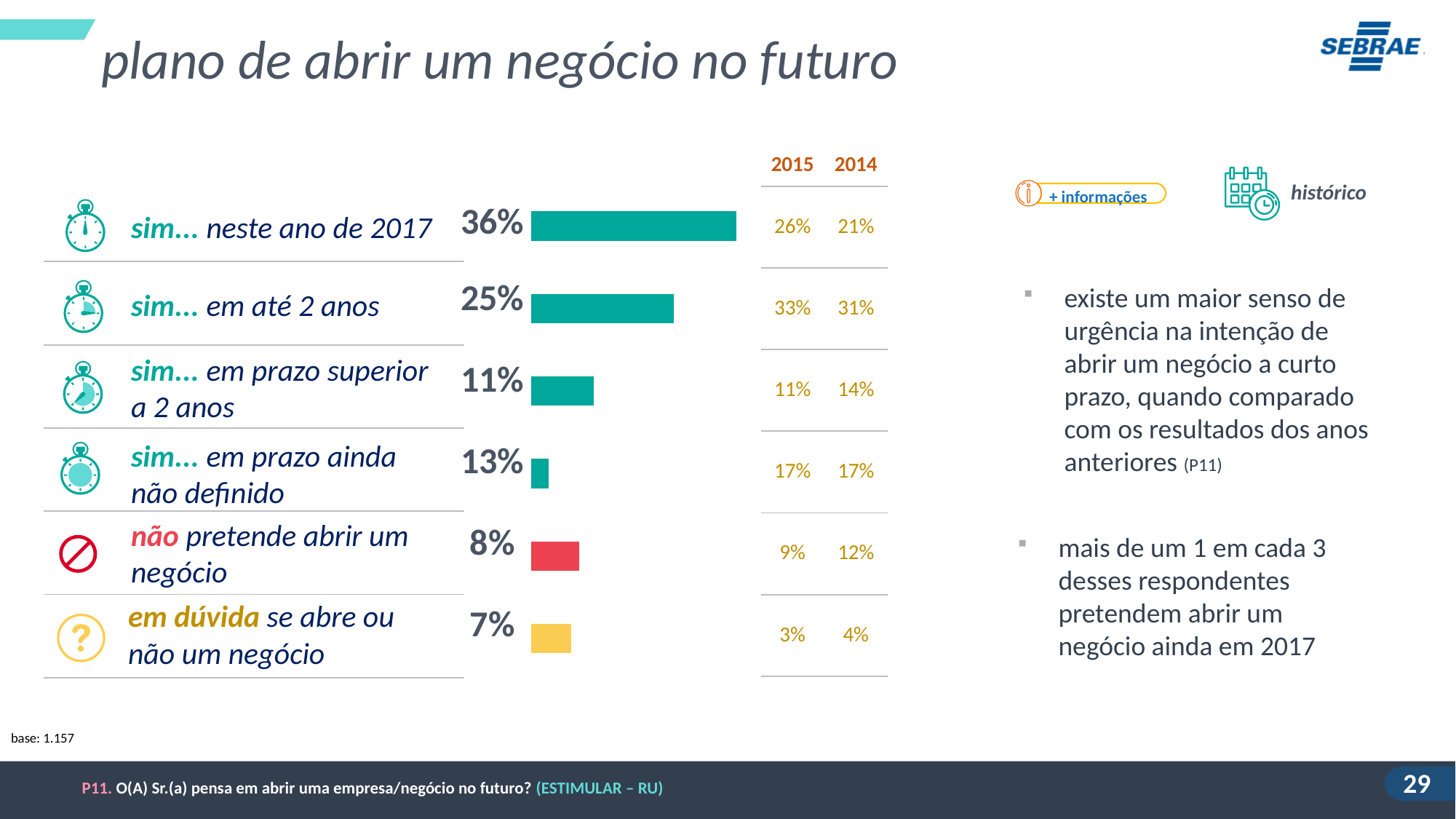
What percentage of respondents plan to open a business this year (2017), according to the bar chart? 36% What is the difference between the values for "sim... neste ano de 2017" and "sim... em até 2 anos"? 11% Which is larger: the value for "não pretende abrir um negócio" or for "em dúvida se abre ou não um negócio"? não pretende abrir um negócio In the table next to the chart, what was the 2015 value for "sim... em até 2 anos"? 33% Which category has the lowest value in the bar chart? em dúvida se abre ou não um negócio What percentage is shown for "não pretende abrir um negócio"? 8% How many categories are shown in the bar chart? 6 What colour is the bar for "não pretende abrir um negócio"? red What kind of chart is shown on the slide? bar chart What is the value for "em dúvida se abre ou não um negócio"? 7% Which category has the highest value in the bar chart? sim... neste ano de 2017 What is the value shown for "sim... em até 2 anos"? 25%